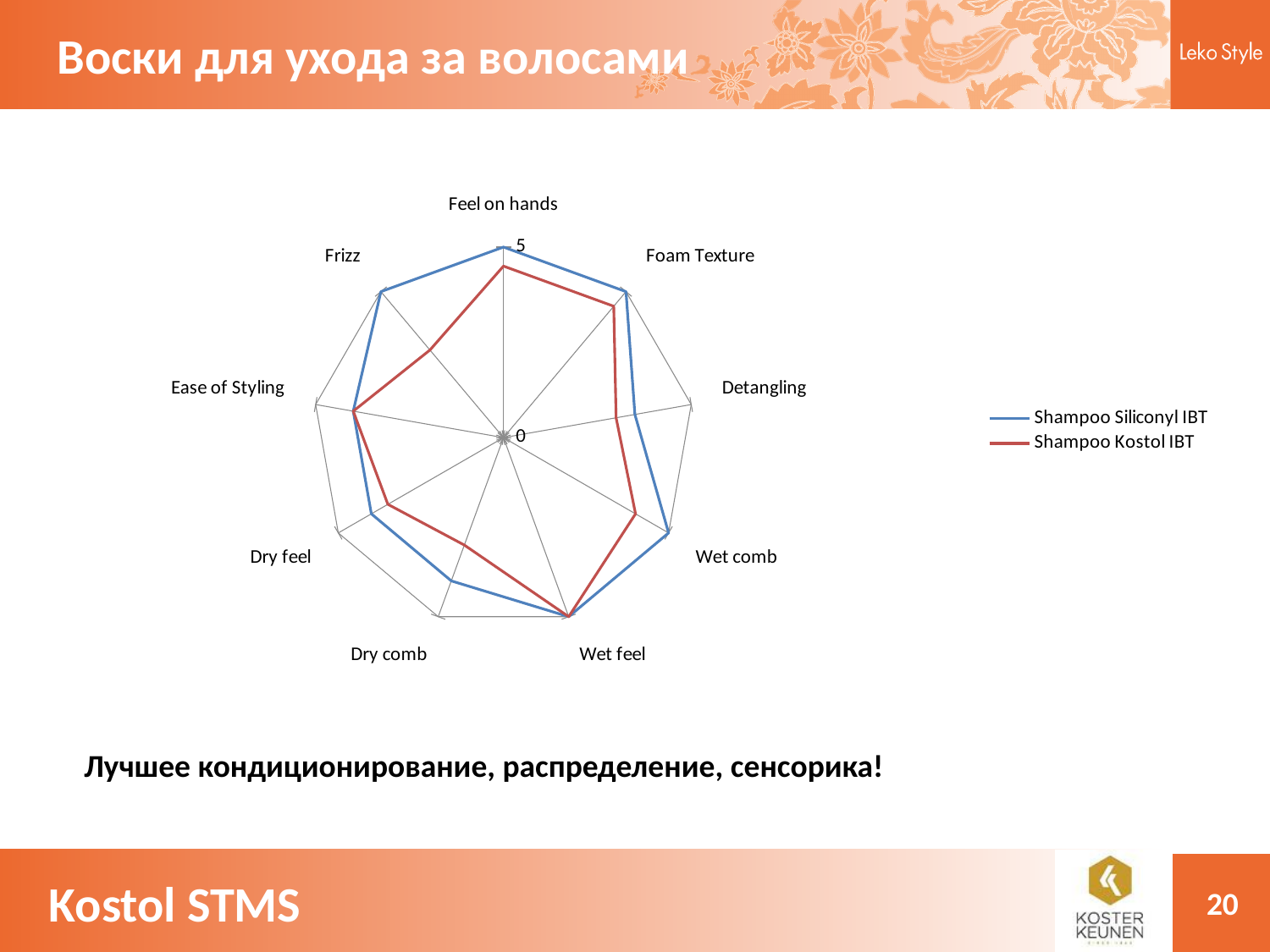
What kind of chart is shown on the slide? Radar chart What is the maximum value shown on the chart's scale? 5 For Feel on hands, which series has the larger value? Shampoo Siliconyl IBT For Detangling, which series has the higher value? Shampoo Siliconyl IBT What are the two series named in the legend? Shampoo Siliconyl IBT and Shampoo Kostol IBT On which category does Shampoo Kostol IBT reach its highest value? Wet feel For Dry comb, which series scores higher? Shampoo Siliconyl IBT Which colour is used for the Shampoo Kostol IBT line? Red How many categories (axes) does the radar chart have? 9 How many series does the chart legend list? 2 What value does Shampoo Siliconyl IBT reach for Feel on hands? 5